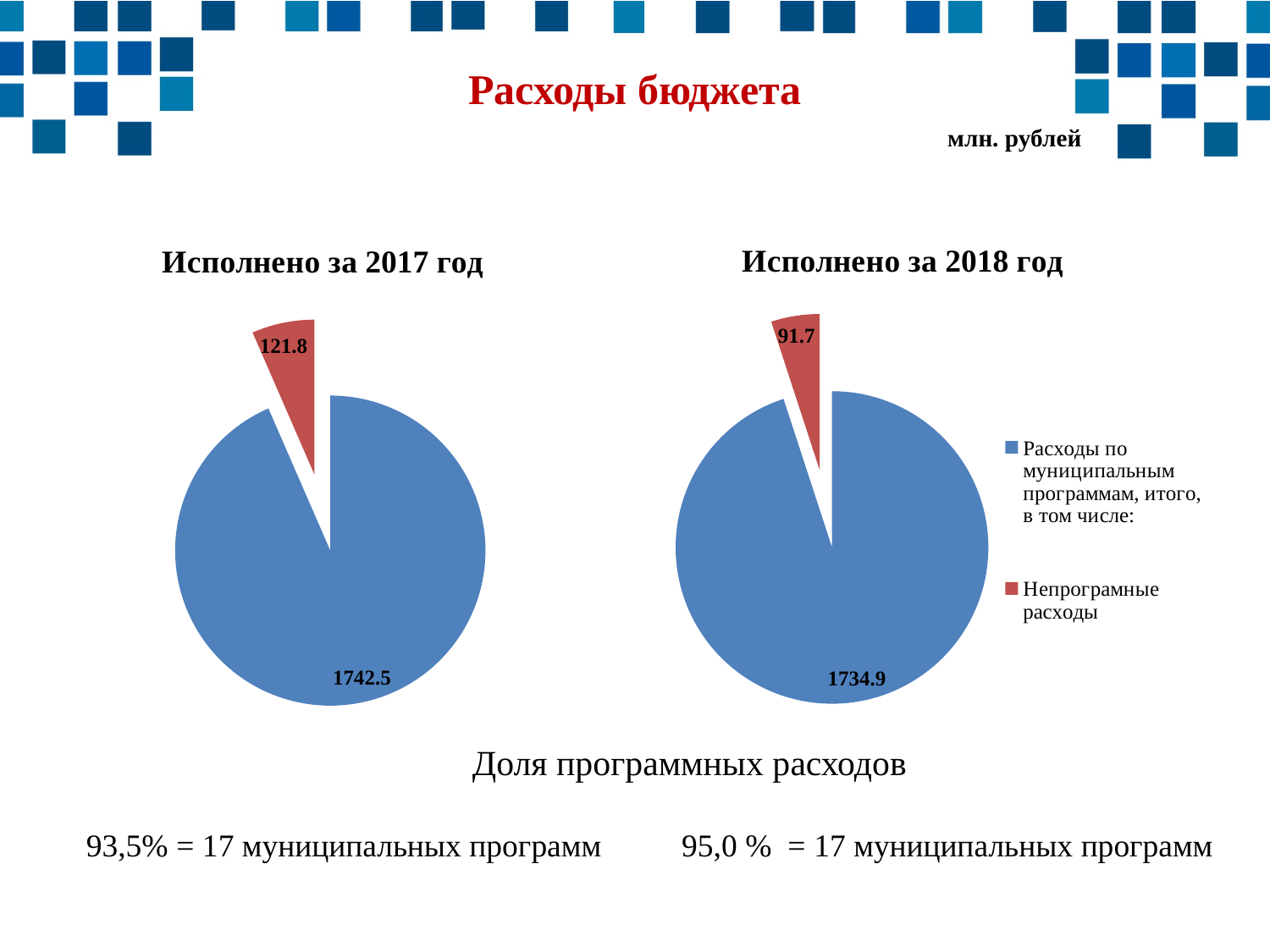
In the "Исполнено за 2018 год" chart, which category has the largest slice? Расходы по муниципальным программам, итого, в том числе: What is the difference between the two values in the "Исполнено за 2017 год" chart? 1620.7 In the "Исполнено за 2017 год" chart, which category has the smallest slice? Непрограмные расходы How many entries does the legend list for the pie charts? 2 How many slices does the "Исполнено за 2017 год" pie chart have? 2 Is the value for "Непрограмные расходы" larger in the "Исполнено за 2017 год" chart or in the "Исполнено за 2018 год" chart? Исполнено за 2017 год What is the total of the two values in the "Исполнено за 2018 год" chart? 1826.6 In the "Исполнено за 2017 год" chart, what is the value for "Расходы по муниципальным программам, итого, в том числе:"? 1742.5 In the "Исполнено за 2018 год" chart, what is the value for "Расходы по муниципальным программам, итого, в том числе:"? 1734.9 What type of chart is used on the slide for "Исполнено за 2017 год"? Pie chart In the "Исполнено за 2017 год" chart, what is the value for "Непрограмные расходы"? 121.8 In the "Исполнено за 2018 год" chart, what is the value for "Непрограмные расходы"? 91.7